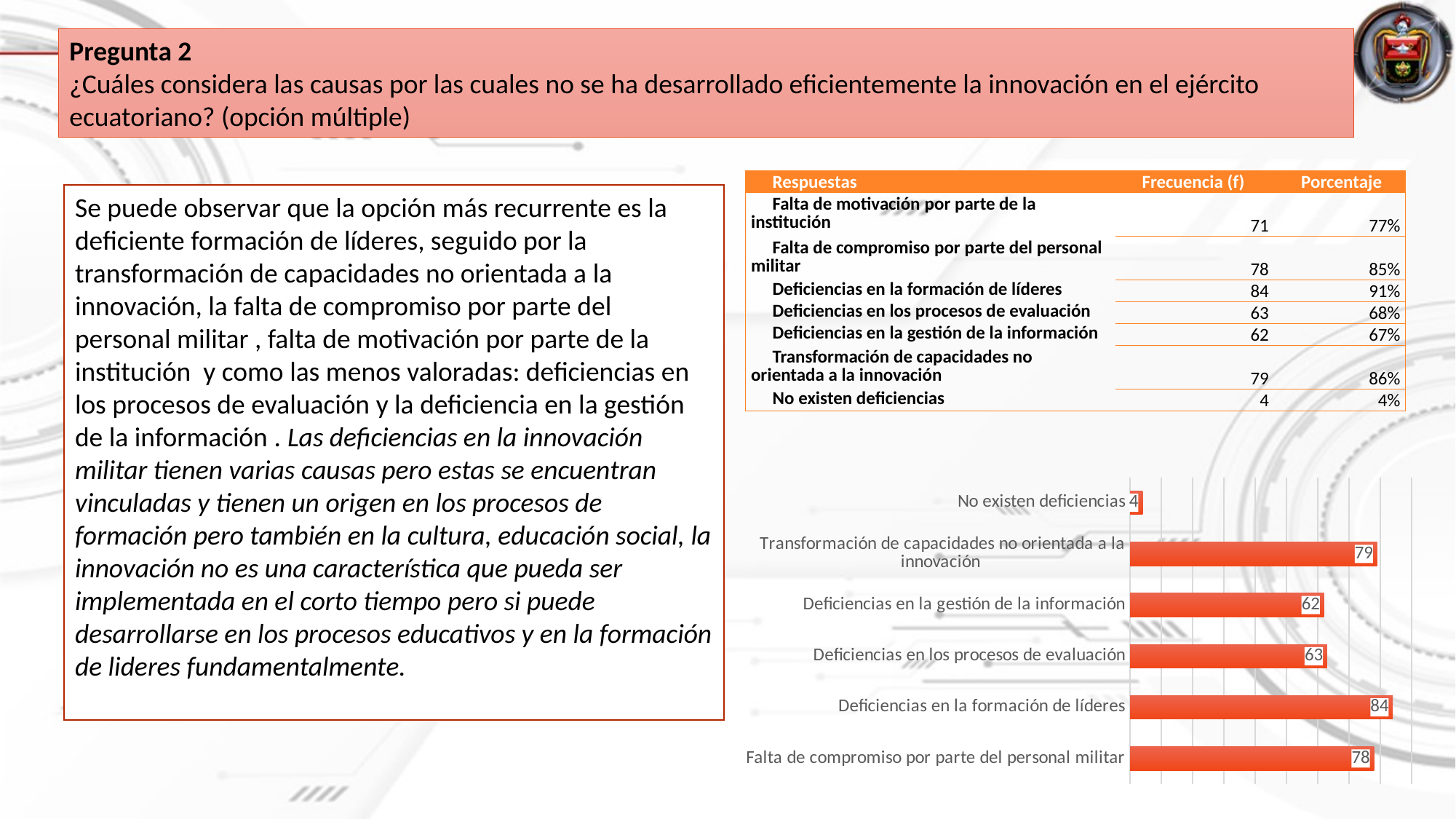
Which category has the highest value in the bar chart? Deficiencias en la formación de líderes What is the value for 'Deficiencias en la formación de líderes' in the bar chart? 84 Which is larger in the bar chart: 'Deficiencias en los procesos de evaluación' or 'Transformación de capacidades no orientada a la innovación'? Transformación de capacidades no orientada a la innovación What is the value for 'Deficiencias en la gestión de la información' in the bar chart? 62 Which category has the lowest value in the bar chart? No existen deficiencias What is the value for 'Falta de compromiso por parte del personal militar' in the bar chart? 78 What type of chart is shown on the slide? bar chart What is the difference between the values for 'Deficiencias en la formación de líderes' and 'Falta de compromiso por parte del personal militar' in the bar chart? 6 What colour are the bars in the bar chart? orange What is the value for 'No existen deficiencias' in the bar chart? 4 What is the value for 'Transformación de capacidades no orientada a la innovación' in the bar chart? 79 How many bars are shown in the bar chart? 6